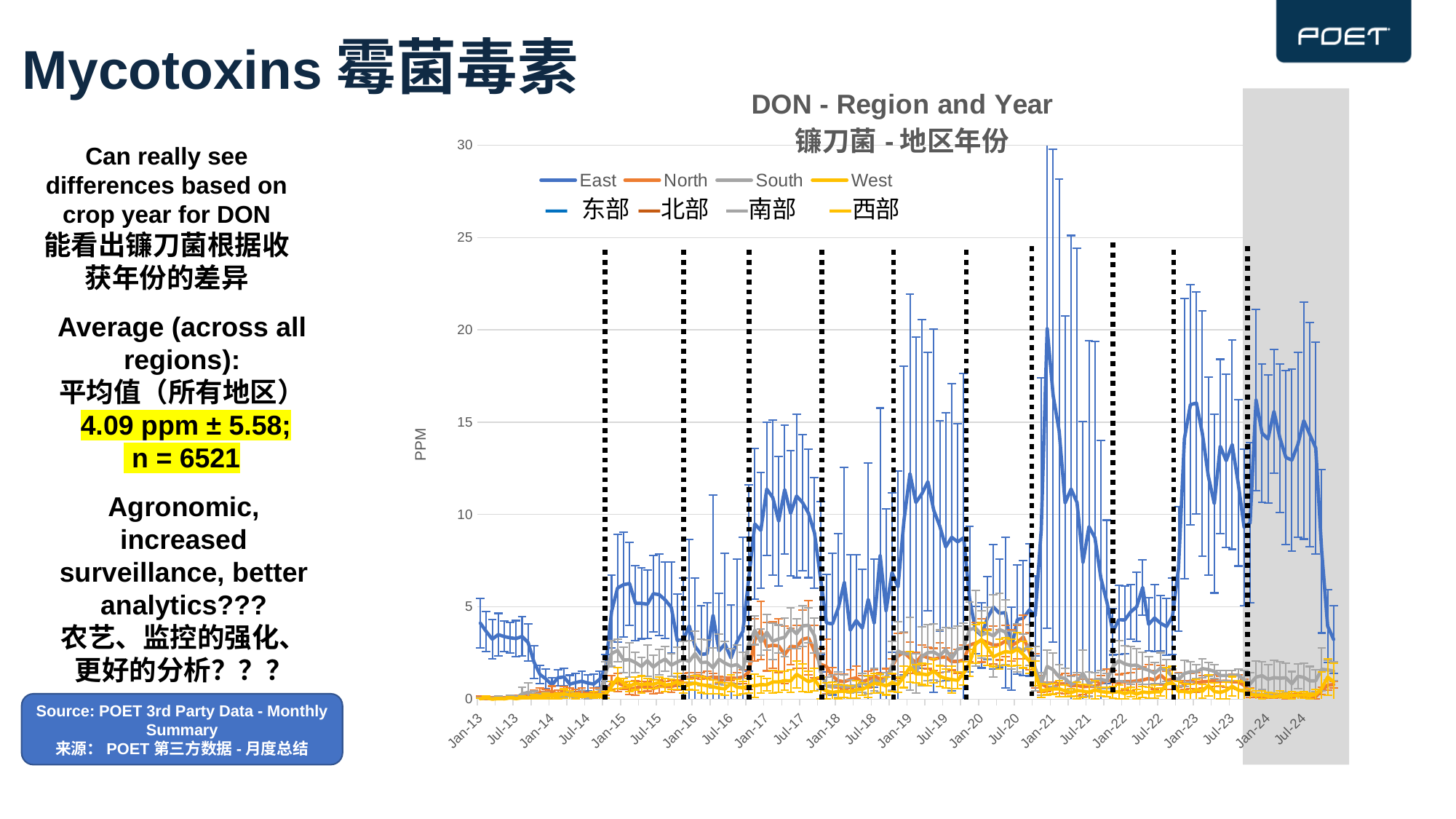
Is the value for West around Jan-21 greater or less than 5? less Which series is larger around Jan-23, East or South? East Is the value for East around Jan-21 greater or less than 15? greater Is the value for East around Jan-24 greater or less than 10? greater What is the title of the chart? DON - Region and Year 镰刀菌 - 地区年份 Does the East series generally rise or fall from Jan-13 to Jan-24? rise How many series does the chart's legend list? 4 What is the label on the vertical axis of the chart? PPM Which region's series reaches the highest values on the chart? East What kind of chart is shown on the slide? line chart